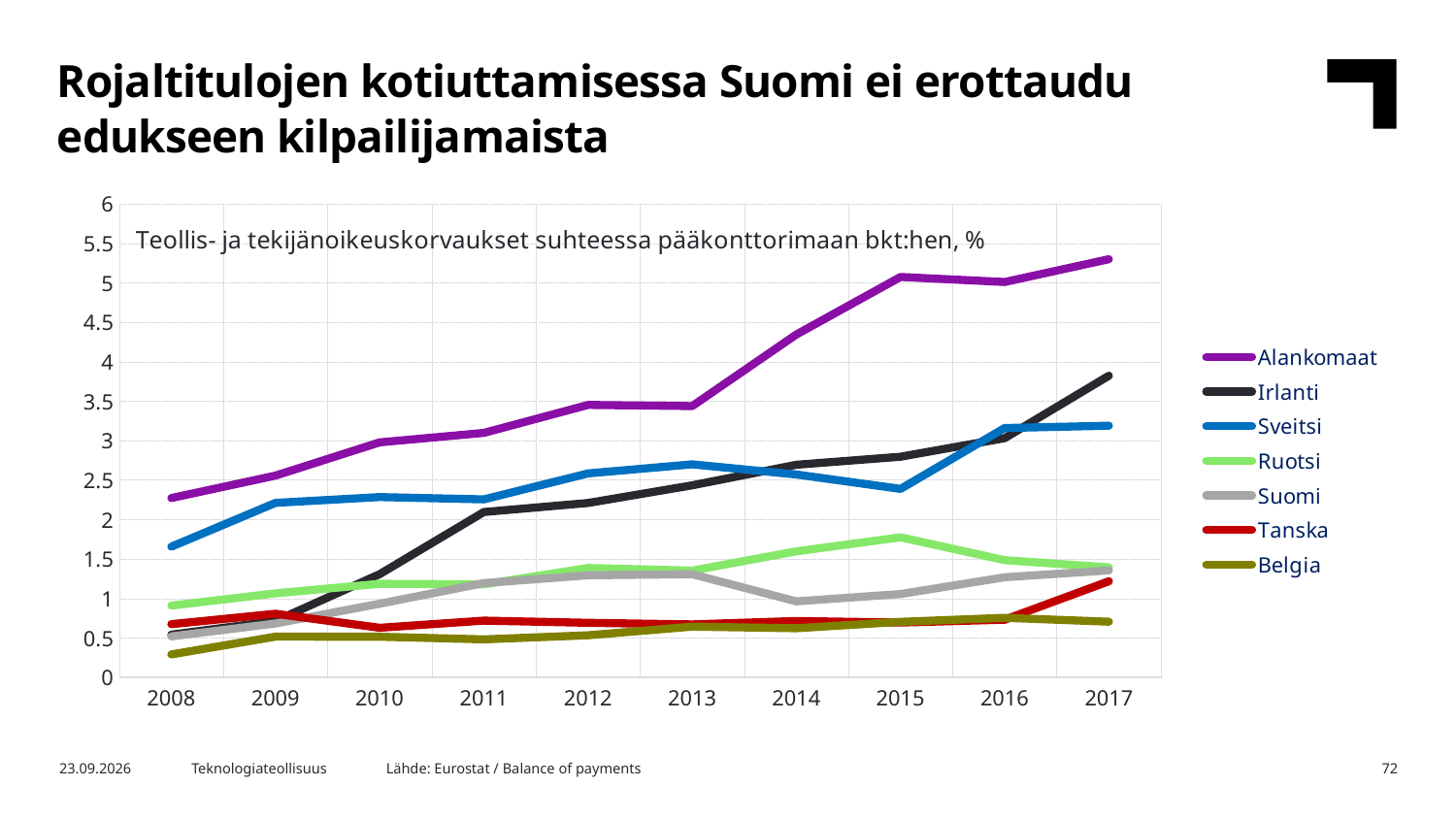
Is the value for Alankomaat in 2017 greater or less than 5? greater What is the title text shown inside the chart area? Teollis- ja tekijänoikeuskorvaukset suhteessa pääkonttorimaan bkt:hen, % Which country has the highest value in 2017? Alankomaat Does the line for Alankomaat rise or fall from 2008 to 2017? rise Which country has the lowest value in 2008? Belgia In 2017, which is larger: the value for Tanska or the value for Belgia? Tanska Is the value for Irlanti in 2008 greater or less than 1? less Is the value for Ruotsi in 2015 greater or less than 1.5? greater In 2017, which is larger: the value for Irlanti or the value for Sveitsi? Irlanti What type of chart is shown on the slide? line chart How many years are shown on the x axis? 10 How many series does the legend list? 7